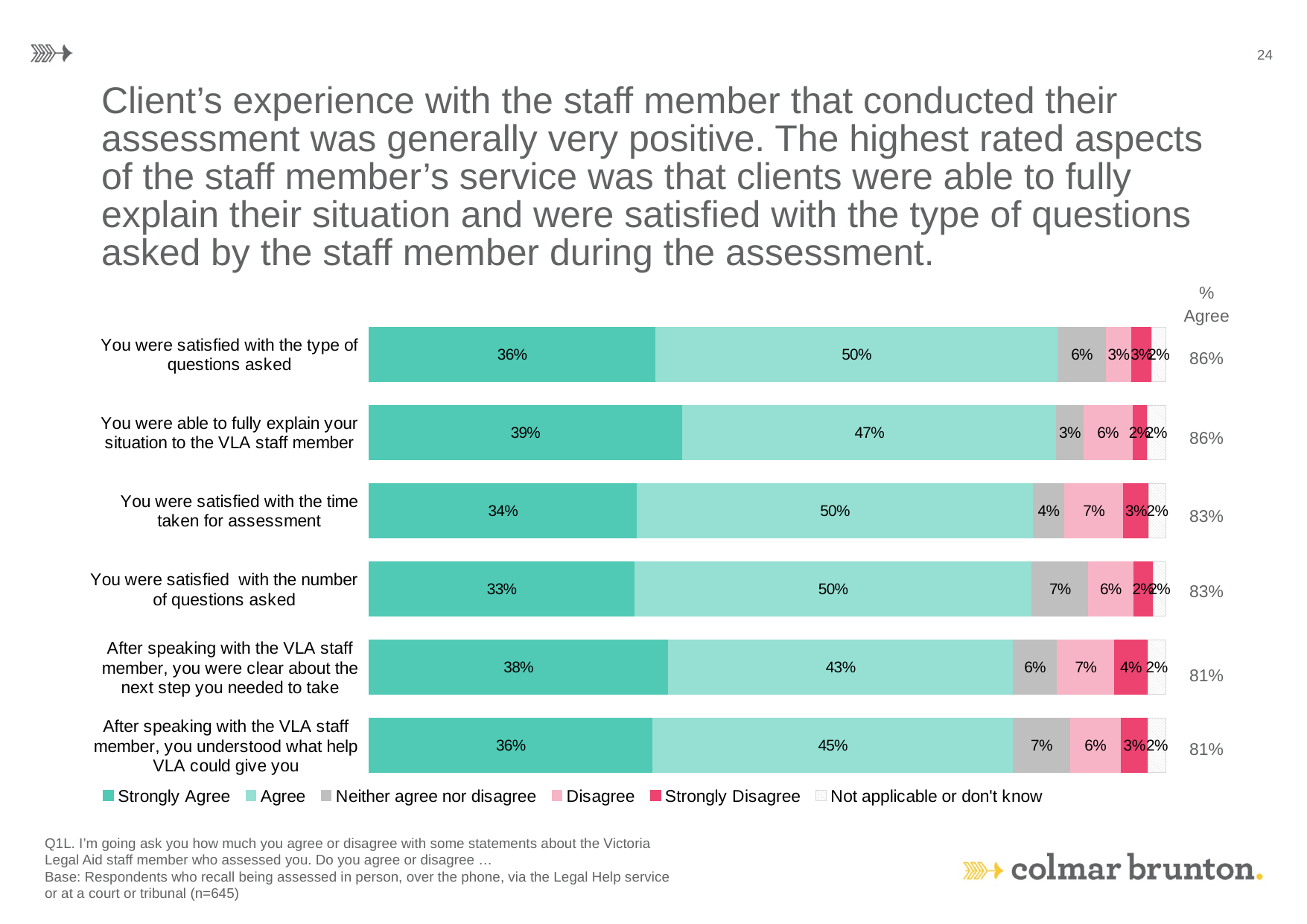
Which statement has the highest 'Strongly Agree' percentage? You were able to fully explain your situation to the VLA staff member Which statement has the lowest 'Agree' percentage? After speaking with the VLA staff member, you were clear about the next step you needed to take What percentage of respondents strongly agreed that they were able to fully explain their situation to the VLA staff member? 39% What is the 'Agree' value for the statement 'After speaking with the VLA staff member, you were clear about the next step you needed to take'? 43% What is the '% Agree' figure shown for 'After speaking with the VLA staff member, you understood what help VLA could give you'? 81% How many statements are shown in the chart? 6 How many series does the legend list? 6 What is the difference in 'Strongly Agree' percentage between 'You were able to fully explain your situation to the VLA staff member' and 'You were satisfied with the number of questions asked'? 6 percentage points What is the 'Neither agree nor disagree' value for 'You were satisfied with the number of questions asked'? 7% What is the total of all segments in the bar for 'After speaking with the VLA staff member, you were clear about the next step you needed to take'? 100% What type of chart is shown on the slide? Stacked bar chart Which has a higher 'Strongly Agree' value: 'After speaking with the VLA staff member, you were clear about the next step you needed to take' or 'You were satisfied with the time taken for assessment'? After speaking with the VLA staff member, you were clear about the next step you needed to take